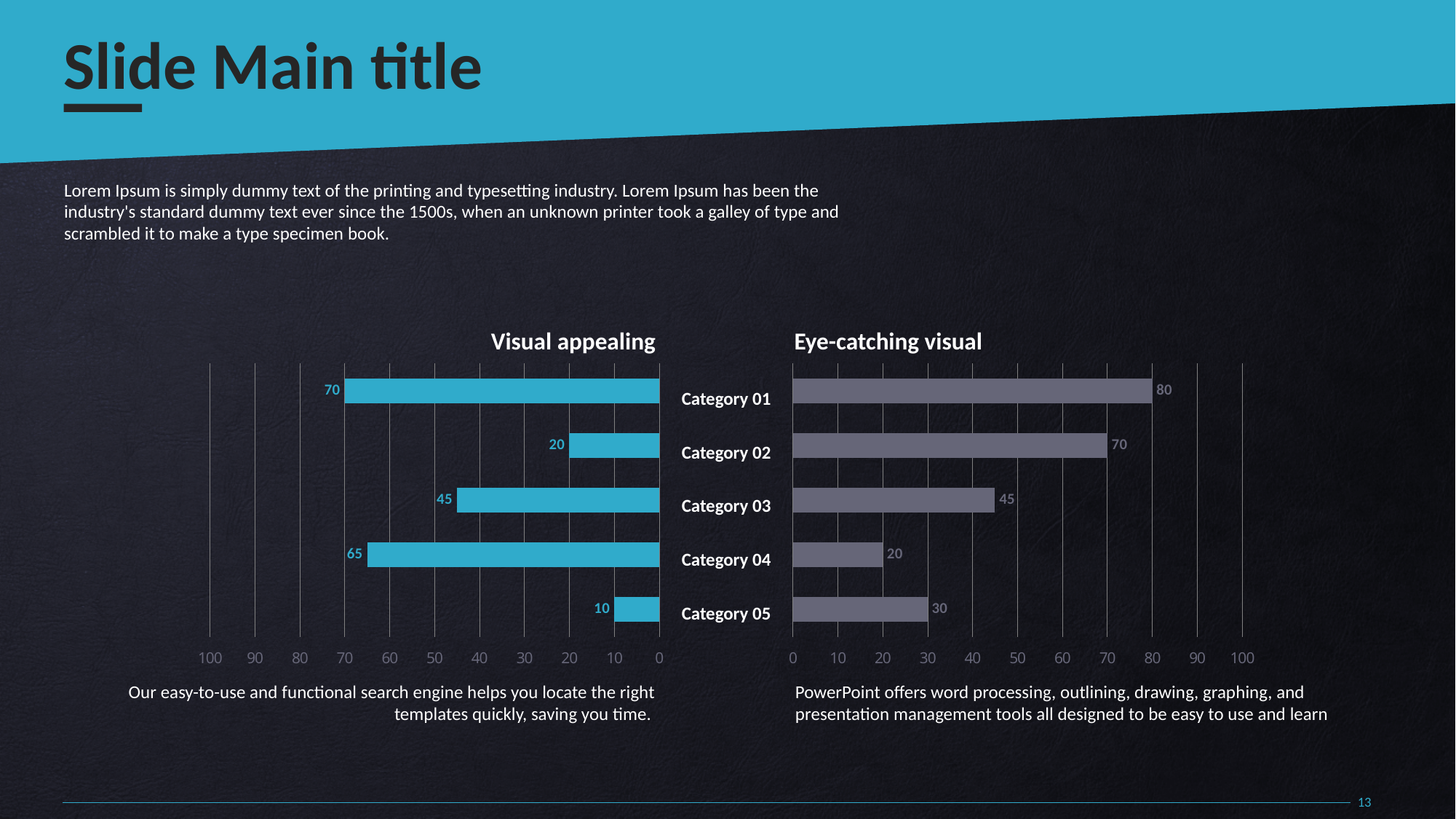
In the 'Visual appealing' chart, which is larger: the value for Category 03 or Category 05? Category 03 In the 'Visual appealing' chart, which category has the lowest value? Category 05 In the 'Visual appealing' chart, what is the value for Category 03? 45 In the 'Eye-catching visual' chart, which is larger: the value for Category 02 or Category 03? Category 02 What colour are the bars in the 'Visual appealing' chart? Blue In the 'Visual appealing' chart, what is the value for Category 01? 70 In the 'Eye-catching visual' chart, what is the value for Category 04? 20 What kind of chart is the 'Eye-catching visual' chart? Bar chart In the 'Visual appealing' chart, what is the difference between the values for Category 04 and Category 02? 45 In the 'Eye-catching visual' chart, what is the difference between the values for Category 01 and Category 05? 50 How many categories are shown in the 'Visual appealing' chart? 5 In the 'Eye-catching visual' chart, which category has the highest value? Category 01